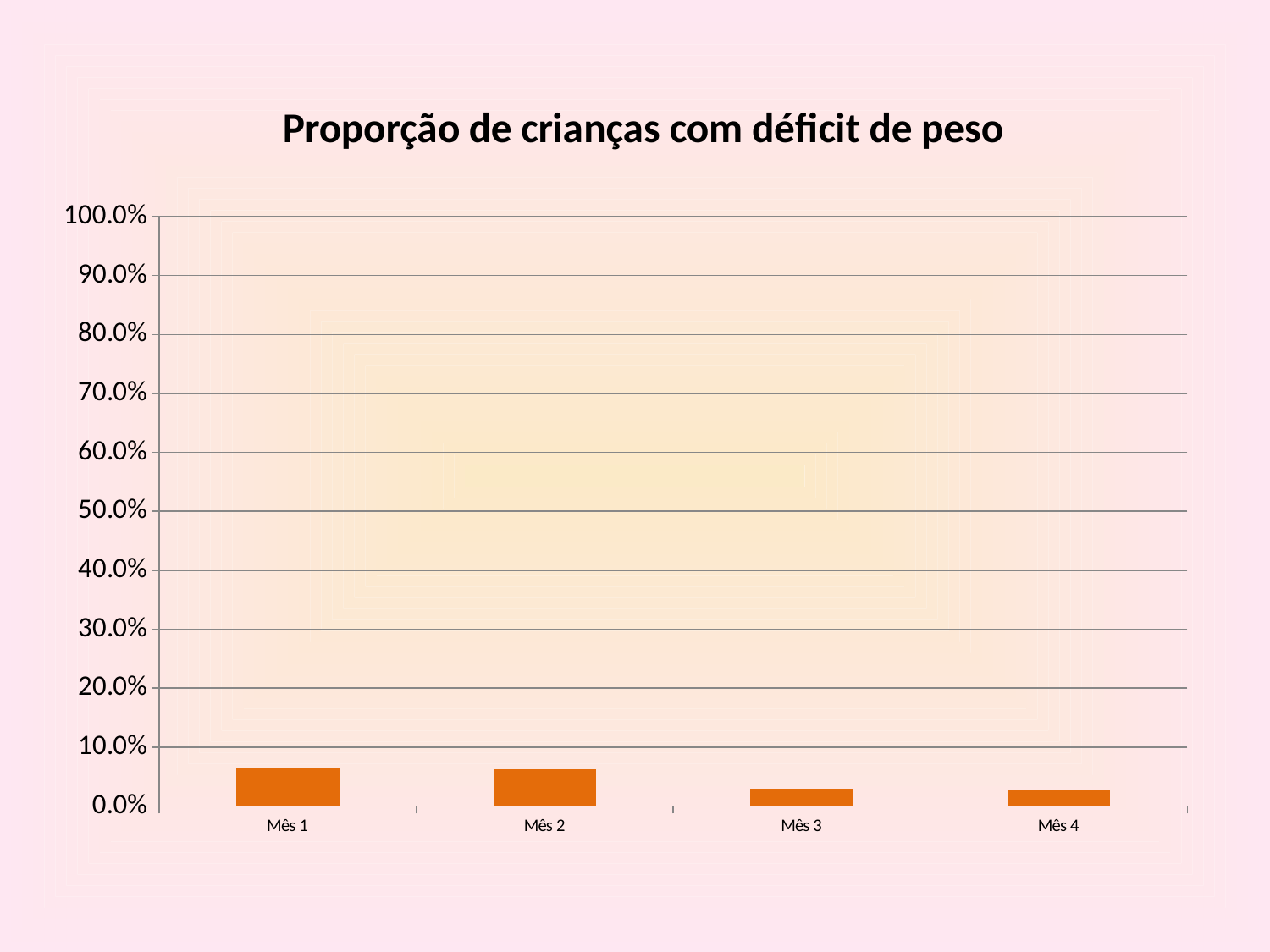
What is the label of the first category on the x axis? Mês 1 Is the value for Mês 3 greater or less than 10.0%? less What is the title of the chart? Proporção de crianças com déficit de peso Which is larger, the value for Mês 1 or the value for Mês 3? Mês 1 What is the highest value shown on the y axis of the chart? 100.0% What kind of chart is shown on the slide? Bar chart Which is larger, the value for Mês 2 or the value for Mês 4? Mês 2 Is the value for Mês 2 greater or less than 10.0%? less Do the values generally rise or fall from Mês 1 to Mês 4? fall Is the value for Mês 1 greater or less than 10.0%? less How many categories are shown on the x axis of the chart? 4